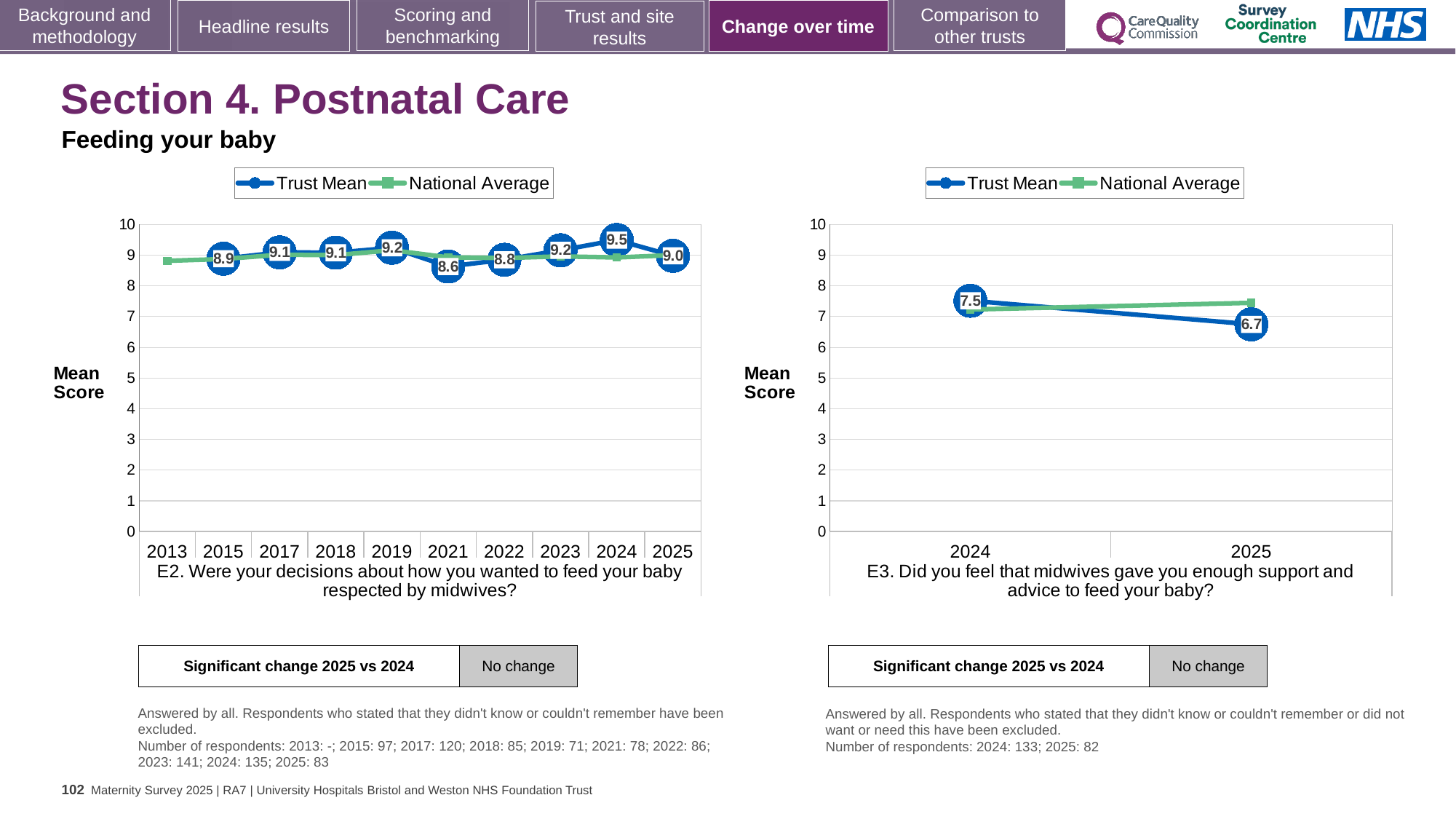
In the E2 chart (left), which year has the lowest Trust Mean? 2021 In the E2 chart (left), what is the Trust Mean for 2021? 8.6 In the E2 chart (left), is the Trust Mean for 2019 greater or less than 8? greater In the E2 chart (left), what is the Trust Mean for 2024? 9.5 In the E2 chart (left), which year has the highest Trust Mean? 2024 What kind of chart is the E3 chart (right)? line chart In the E2 chart (left), what is the difference between the Trust Mean for 2024 and the Trust Mean for 2025? 0.5 In the E3 chart (right), which is larger, the Trust Mean for 2024 or the Trust Mean for 2025? 2024 In the E3 chart (right), does the Trust Mean rise or fall from 2024 to 2025? fall In the E3 chart (right), how many series does the legend list? 2 In the E2 chart (left), how many years are shown on the x axis? 10 In the E3 chart (right), what is the Trust Mean for 2025? 6.7